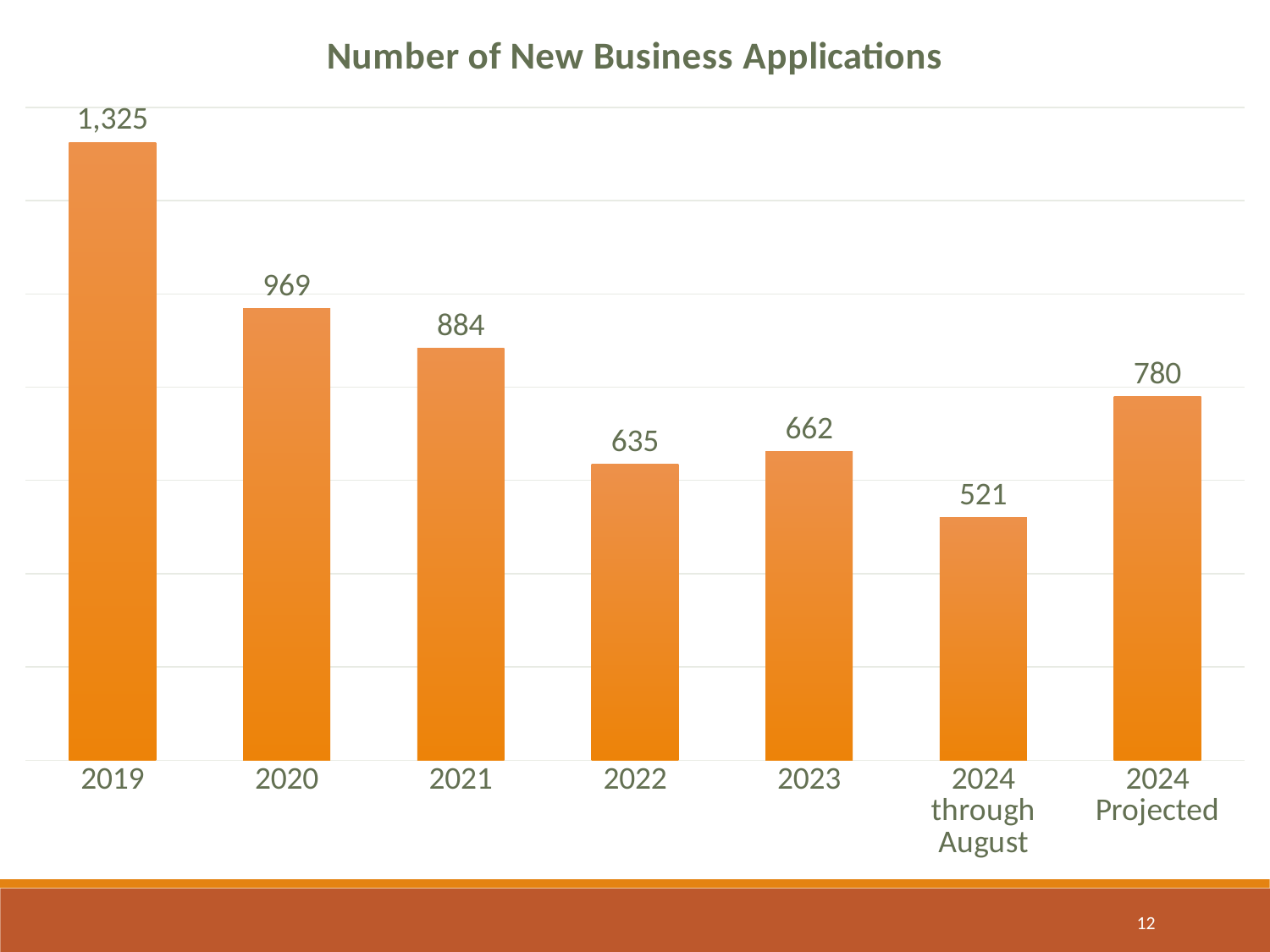
Which is larger, the value for 2022 or the value for 2023? 2023 What is the title of the chart? Number of New Business Applications What is the difference between the values for 2019 and 2024 Projected? 545 What is the number of new business applications for 2022? 635 Which category has the lowest number of new business applications? 2024 through August What is the value shown for 2024 through August? 521 Which category has the highest number of new business applications? 2019 What kind of chart is shown on the slide? Bar chart What is the difference between the values for 2020 and 2021? 85 What is the number of new business applications for 2019? 1,325 How many categories are shown on the x axis? 7 What is the value shown for 2024 Projected? 780